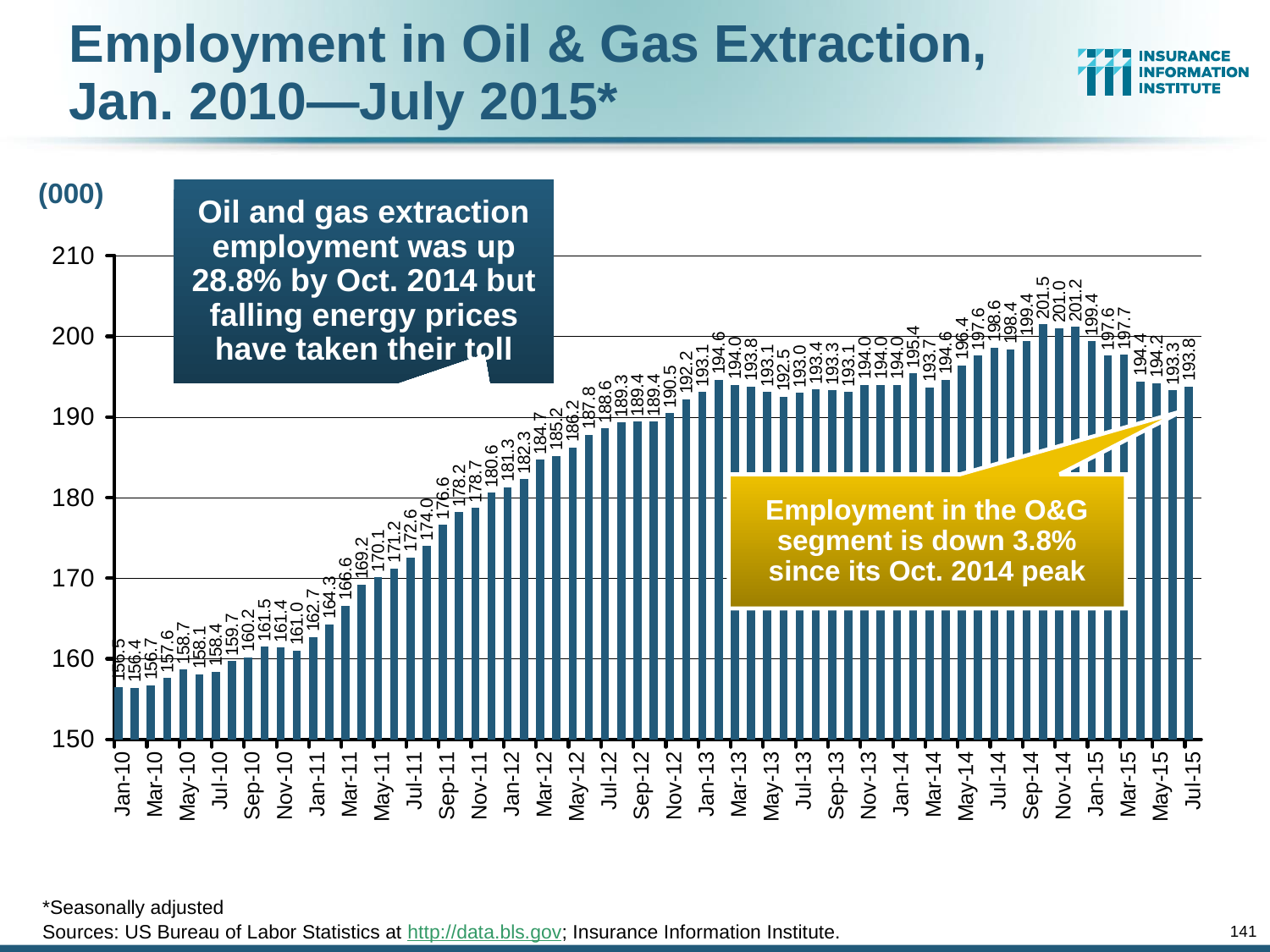
What kind of chart is shown on the slide? bar chart Is the value for Jan-11 greater or less than 160? greater Which month has the lowest employment value? Feb-10 What is the difference between the Jul-15 value and the Jan-10 value? 37.3 In what units are the values on the y axis expressed? (000) What is the employment value for Jan-12? 181.3 Which month has the highest employment value? Oct-14 What is the employment value for Oct-14? 201.5 What is the employment value for Jan-10? 156.5 What is the employment value for Jul-15? 193.8 Do the values generally rise or fall from Jan-10 to Oct-14? rise Which is larger, the value for Jan-15 or the value for Jan-14? Jan-15